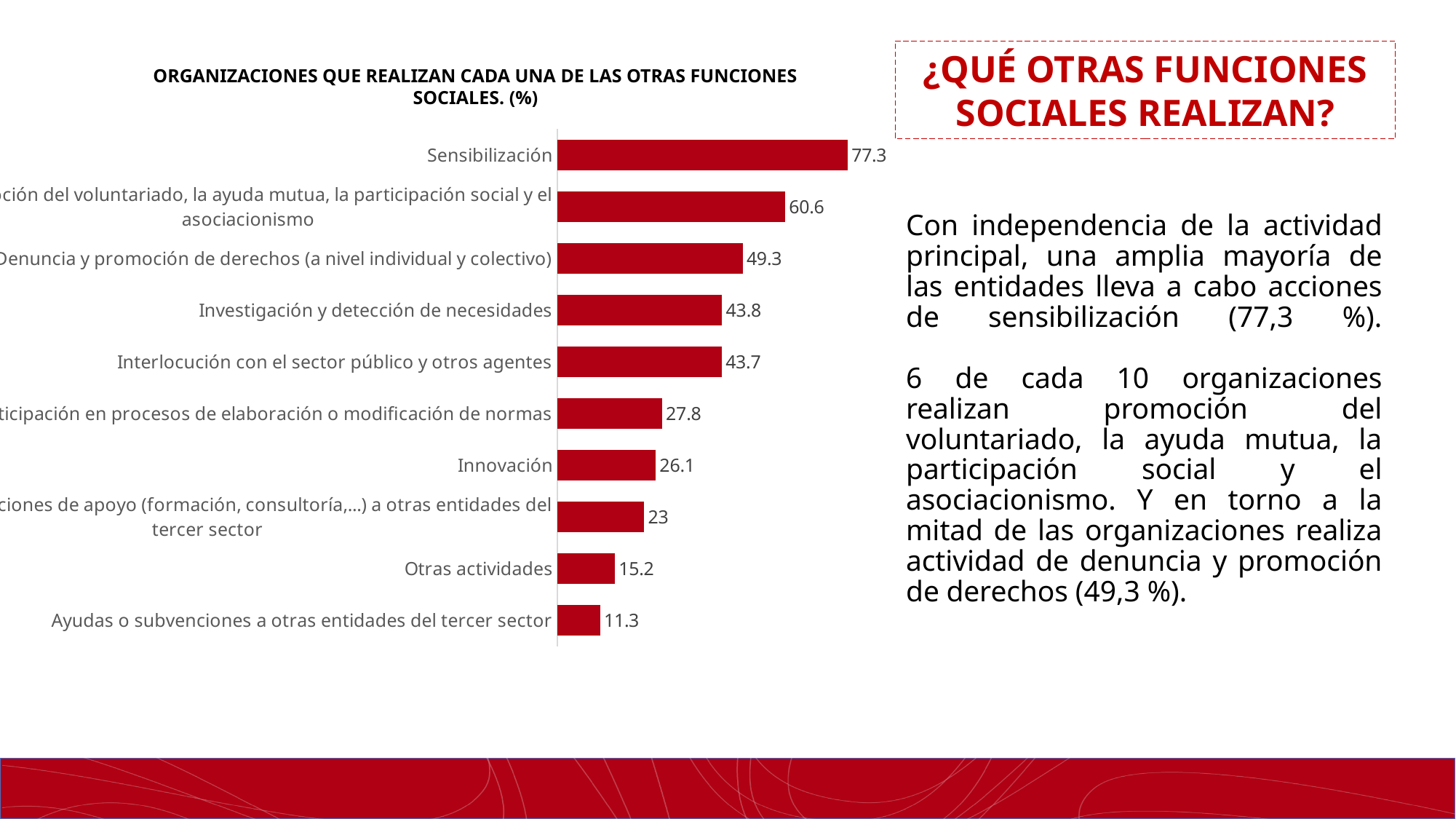
What is the value for Sensibilización? 77.3 What is the difference between the values for Sensibilización and Ayudas o subvenciones a otras entidades del tercer sector? 66 What is the value for Investigación y detección de necesidades? 43.8 What is the value for Ayudas o subvenciones a otras entidades del tercer sector? 11.3 Which category has the highest value? Sensibilización How many categories (bars) does the chart show? 10 What is the value for Innovación? 26.1 Which category has the lowest value? Ayudas o subvenciones a otras entidades del tercer sector Which is larger, the value for Innovación or the value for Otras actividades? Innovación What type of chart is shown on the slide? Bar chart What is the title of the chart? ORGANIZACIONES QUE REALIZAN CADA UNA DE LAS OTRAS FUNCIONES SOCIALES. (%) What is the value for Otras actividades? 15.2